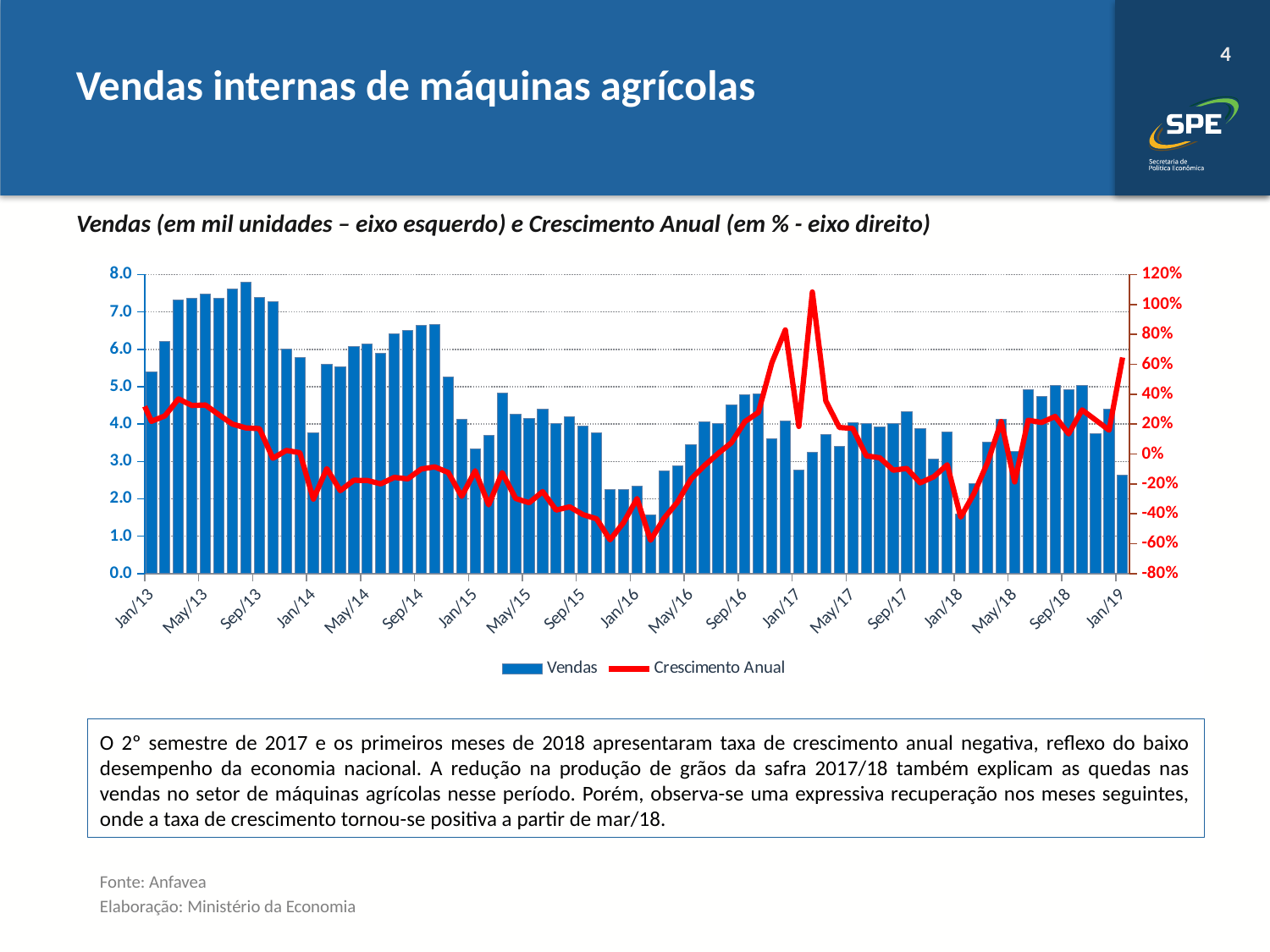
What kind of chart is shown on the slide? A combined bar and line chart How many series does the chart legend list? 2 Is the Crescimento Anual value for Jan/18 greater or less than -20%? less Is the Vendas value for Jan/18 greater or less than 3.0? less Is the Vendas value for Sep/14 greater or less than 6.0? greater What are the two series named in the chart legend? Vendas and Crescimento Anual Do the Vendas bars generally rise or fall from Jan/13 to Jan/16? fall Which series is drawn as a red line? Crescimento Anual